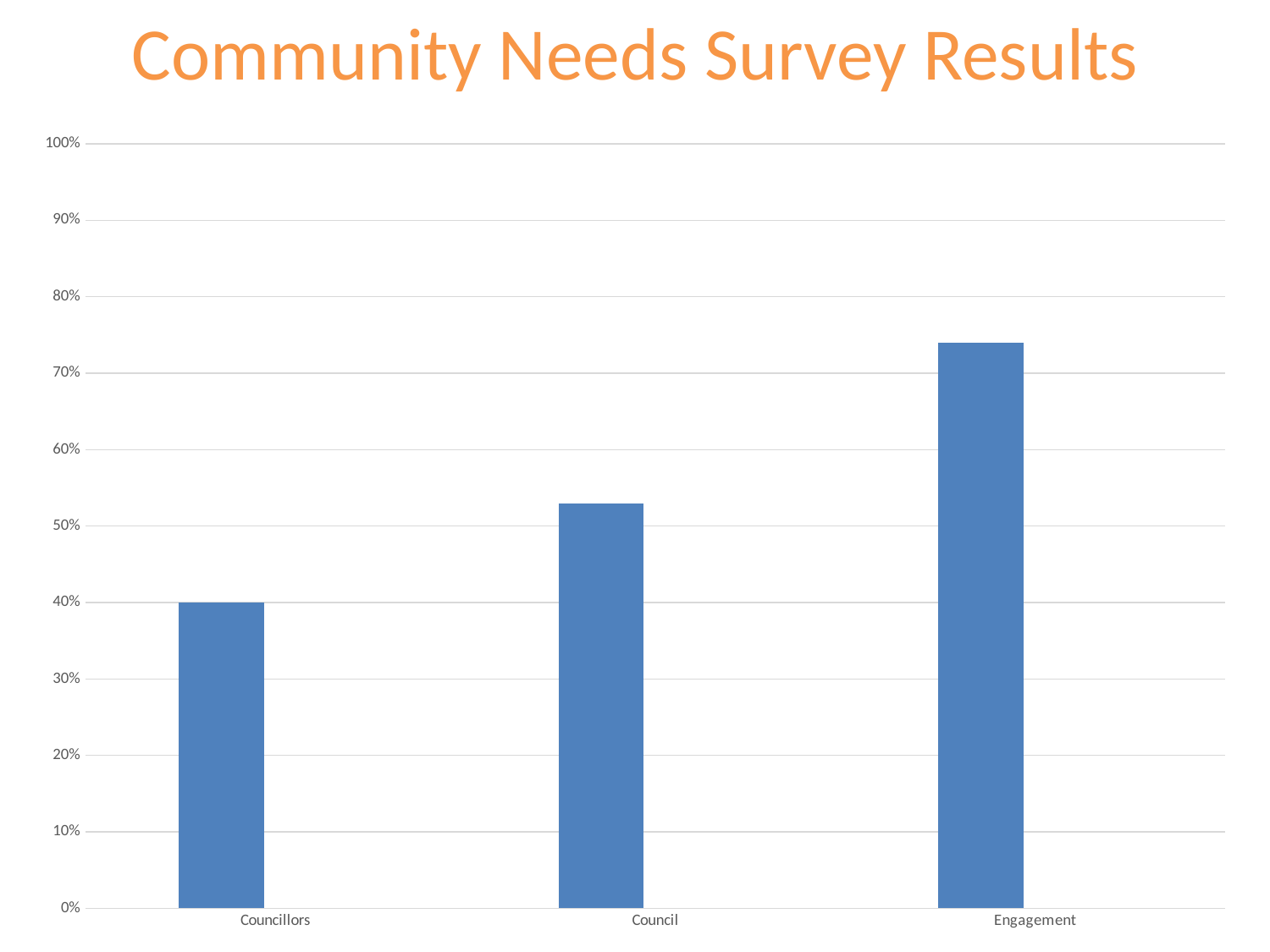
What is the title of the chart? Community Needs Survey Results Is the value for Council greater or less than 60%? less Is the value for Engagement greater or less than 70%? greater Which category has the highest value? Engagement Is the value for Council greater or less than 50%? greater Which category has the lowest value? Councillors Do the values rise or fall from Councillors to Engagement along the x axis? rise Which is larger, the value for Council or the value for Councillors? Council What is the value for Councillors? 40% What kind of chart is shown on the slide? bar chart How many categories are plotted on the chart? 3